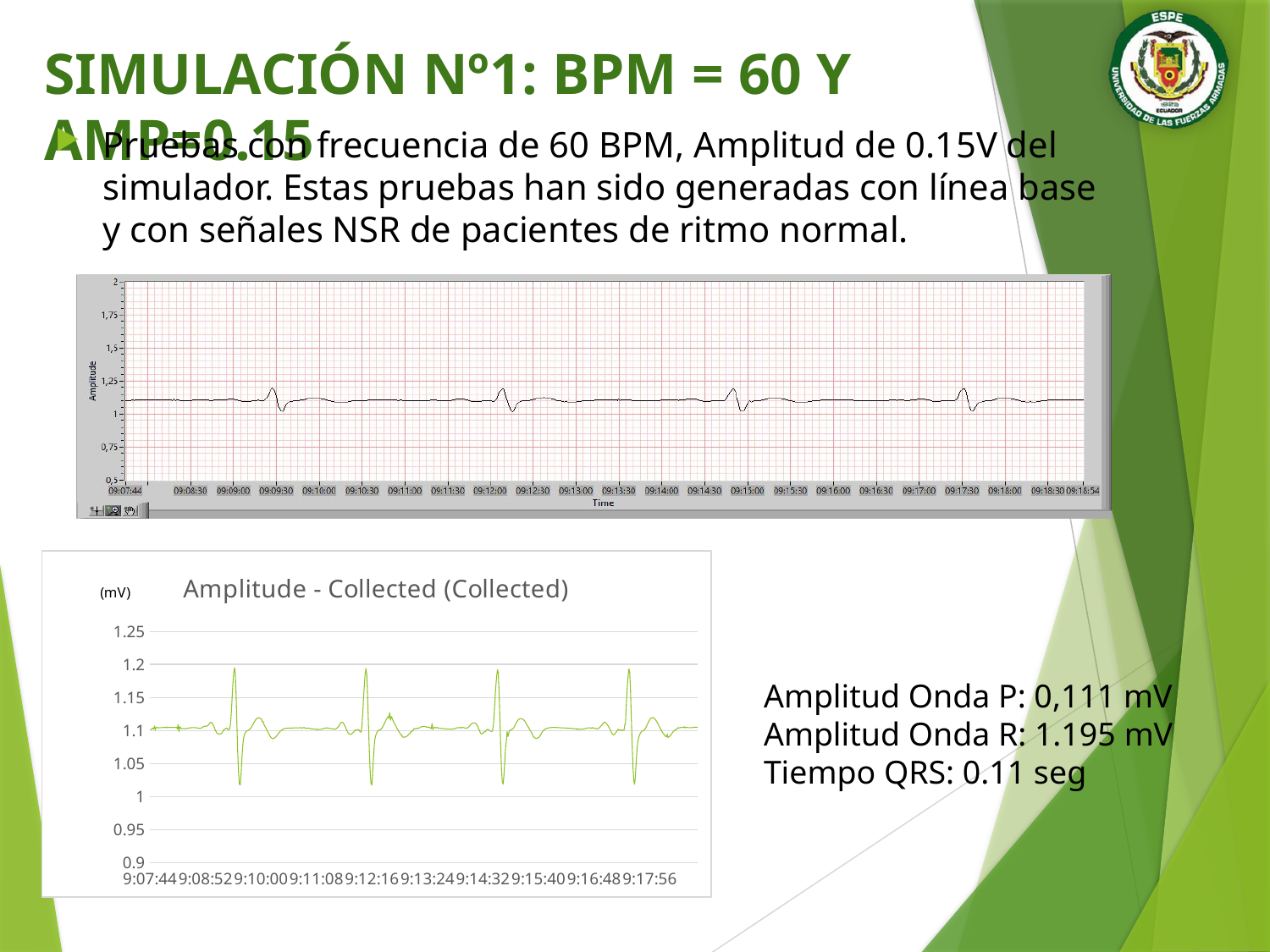
What kind of chart is the bottom chart titled "Amplitude - Collected (Collected)"? line chart What is the lowest value shown on the y axis of the bottom chart? 0.9 In the bottom chart, how many large upward R peaks are visible in the trace? 4 What is the last time label on the x axis of the bottom chart? 9:17:56 In the bottom chart, is the baseline level of the trace greater or less than 1.05? greater In the bottom chart, is the highest peak of the trace greater or less than 1.15? greater What is the title of the bottom chart? Amplitude - Collected (Collected) What is the first time label on the x axis of the bottom chart? 9:07:44 In the bottom chart, is the lowest dip of the trace greater or less than 1.05? less What unit is shown on the y axis of the bottom chart? mV In the top chart, how many large upward spikes are visible in the trace? 4